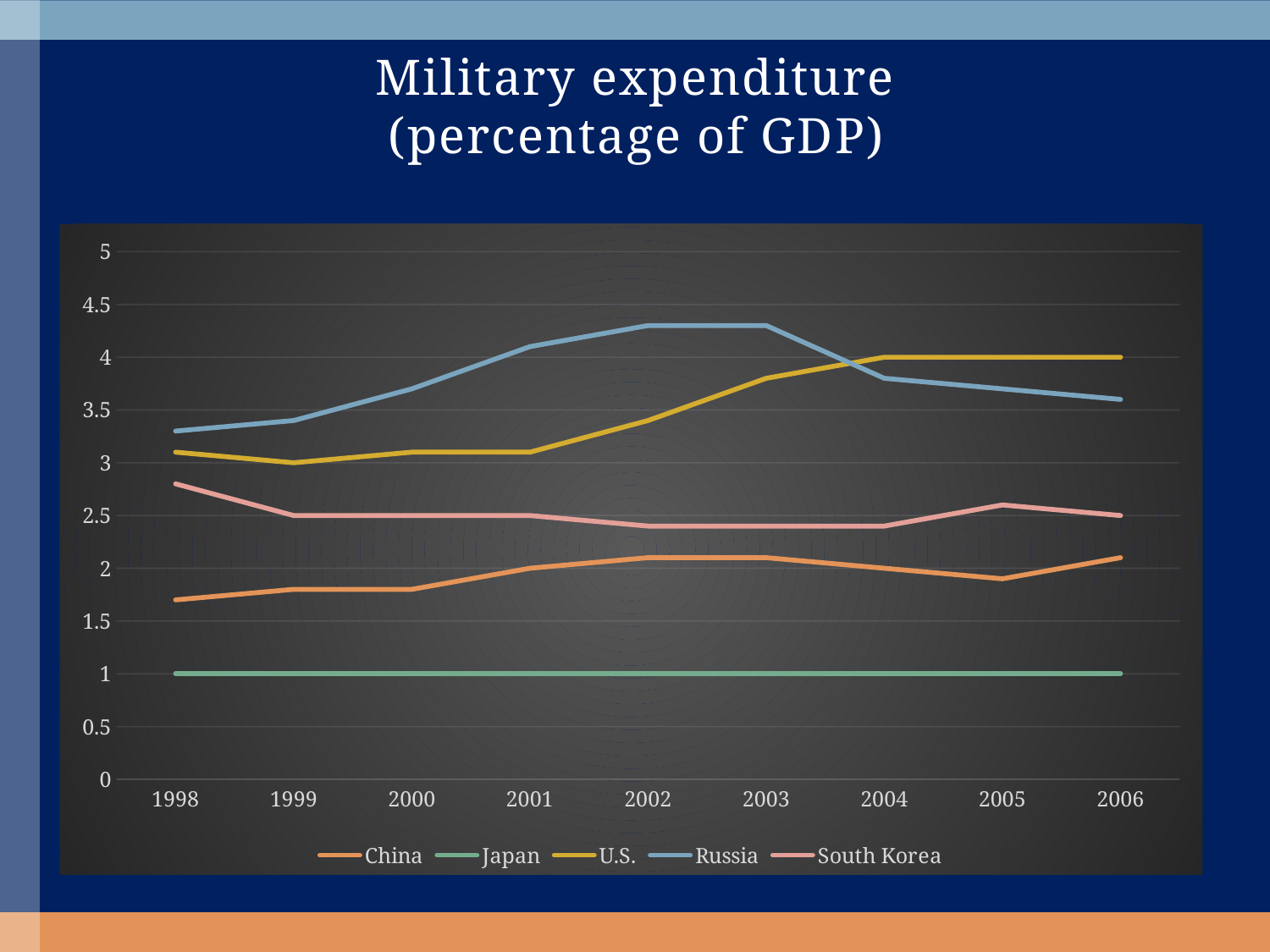
Which country has the lowest military expenditure in 2006? Japan Which country has the highest military expenditure in 2002? Russia Does the U.S. line rise or fall from 2001 to 2004? rise In 2006, which is larger: the value for the U.S. or the value for Russia? U.S. How many years are shown on the x axis? 9 What is the value for Japan in 2000? 1 Is the value for China in 1998 greater or less than 2? less What is the value for the U.S. in 2005? 4 How many series does the legend list? 5 Is the value for Russia in 2001 greater or less than 4? greater What is the title of the chart? Military expenditure (percentage of GDP) What kind of chart is shown on the slide? line chart